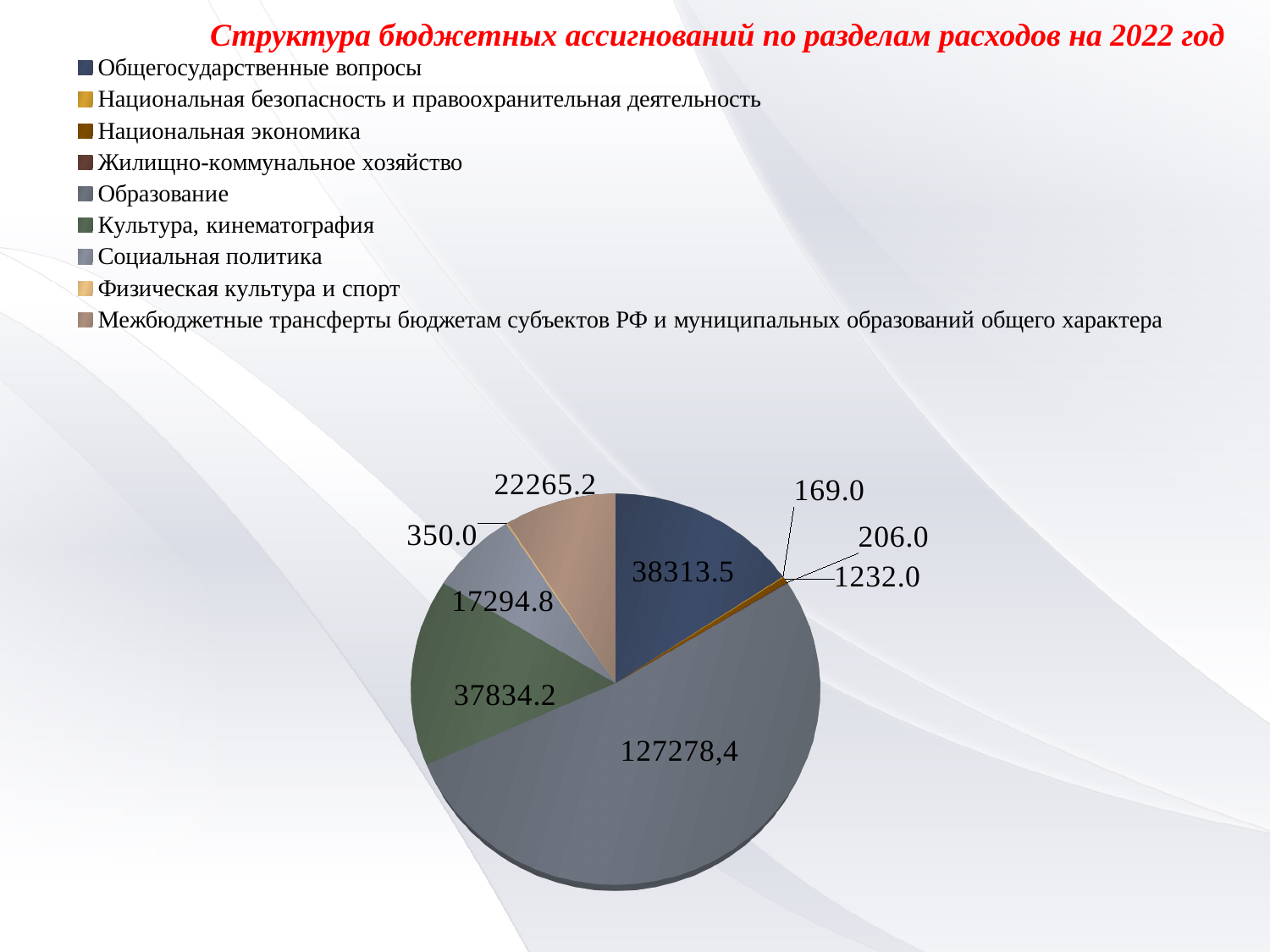
Which category has the largest slice of the pie? Образование What is the value shown for Физическая культура и спорт? 350.0 What is the value shown for Социальная политика? 17294.8 Which category has the smallest value in the pie chart? Национальная безопасность и правоохранительная деятельность What is the value shown for Образование? 127278,4 Which is larger: the value for Образование or the value for Культура, кинематография? Образование What is the value shown for Общегосударственные вопросы? 38313.5 What is the difference between the value for Межбюджетные трансферты бюджетам субъектов РФ и муниципальных образований общего характера and the value for Социальная политика? 4970.4 What is the value shown for Межбюджетные трансферты бюджетам субъектов РФ и муниципальных образований общего характера? 22265.2 What type of chart is shown on the slide? Pie chart How many categories does the legend of the pie chart list? 9 What is the value shown for Культура, кинематография? 37834.2